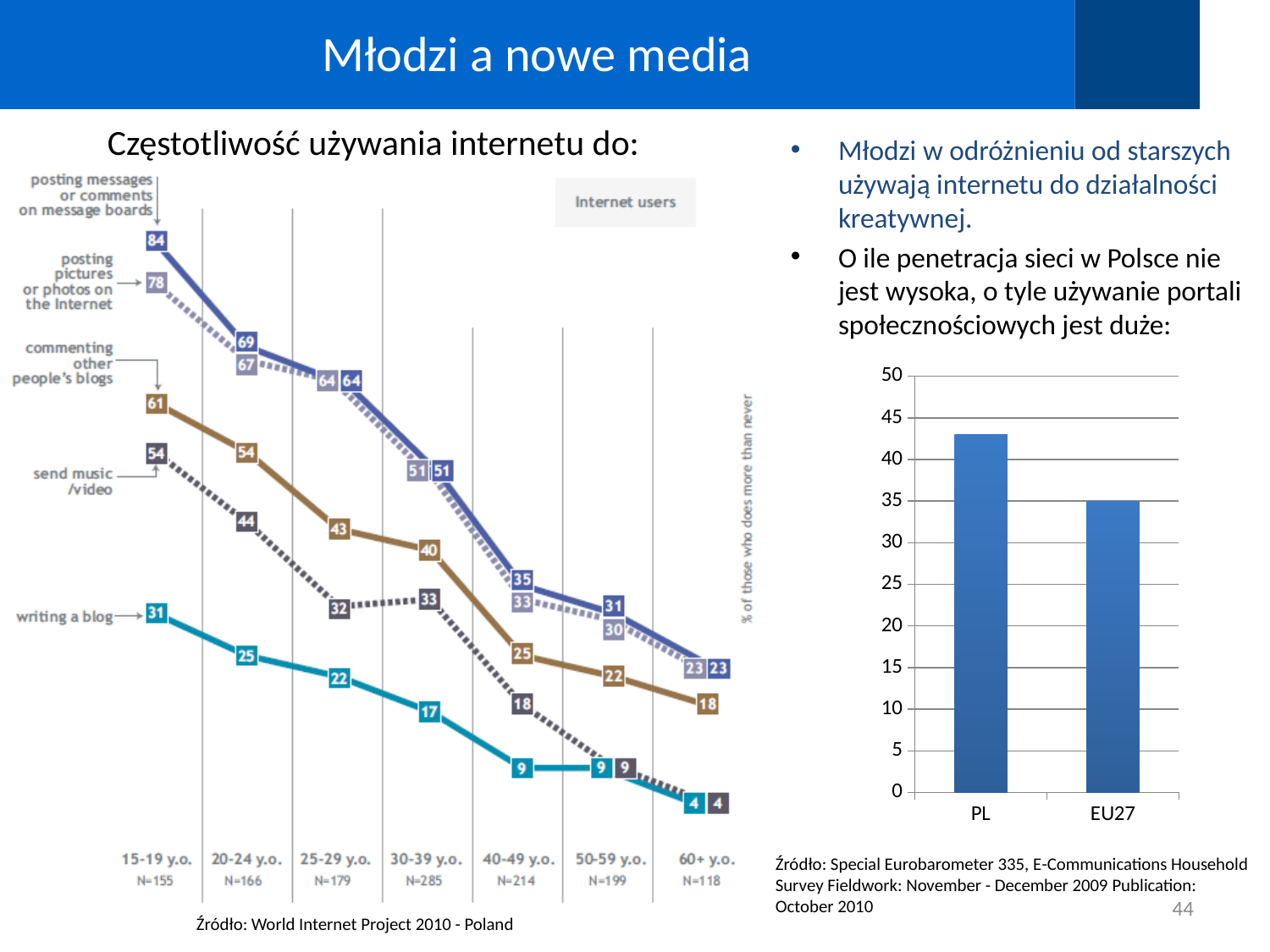
In the bar chart on the right, is the value for PL greater or less than 40? greater In the left chart 'Częstotliwość używania internetu do:', what is the difference between the 15-19 y.o. and 60+ y.o. values for send music/video? 50 In the left chart 'Częstotliwość używania internetu do:', how many activity series are plotted? 5 What kind of chart is the chart on the right of the slide? bar chart In the bar chart on the right, what is the value for EU27? 35 In the left chart 'Częstotliwość używania internetu do:', what is the value for writing a blog in the 30-39 y.o. group? 17 In the left chart 'Częstotliwość używania internetu do:', which age group has the highest value for commenting other people's blogs? 15-19 y.o. In the bar chart on the right, which category has the higher value, PL or EU27? PL In the left chart 'Częstotliwość używania internetu do:', how many age groups are shown on the x axis? 7 In the left chart 'Częstotliwość używania internetu do:', do the values for posting pictures or photos on the Internet rise or fall as age increases? fall In the left chart 'Częstotliwość używania internetu do:', what is the value for posting messages or comments on message boards in the 15-19 y.o. group? 84 How many bars are shown in the bar chart on the right? 2